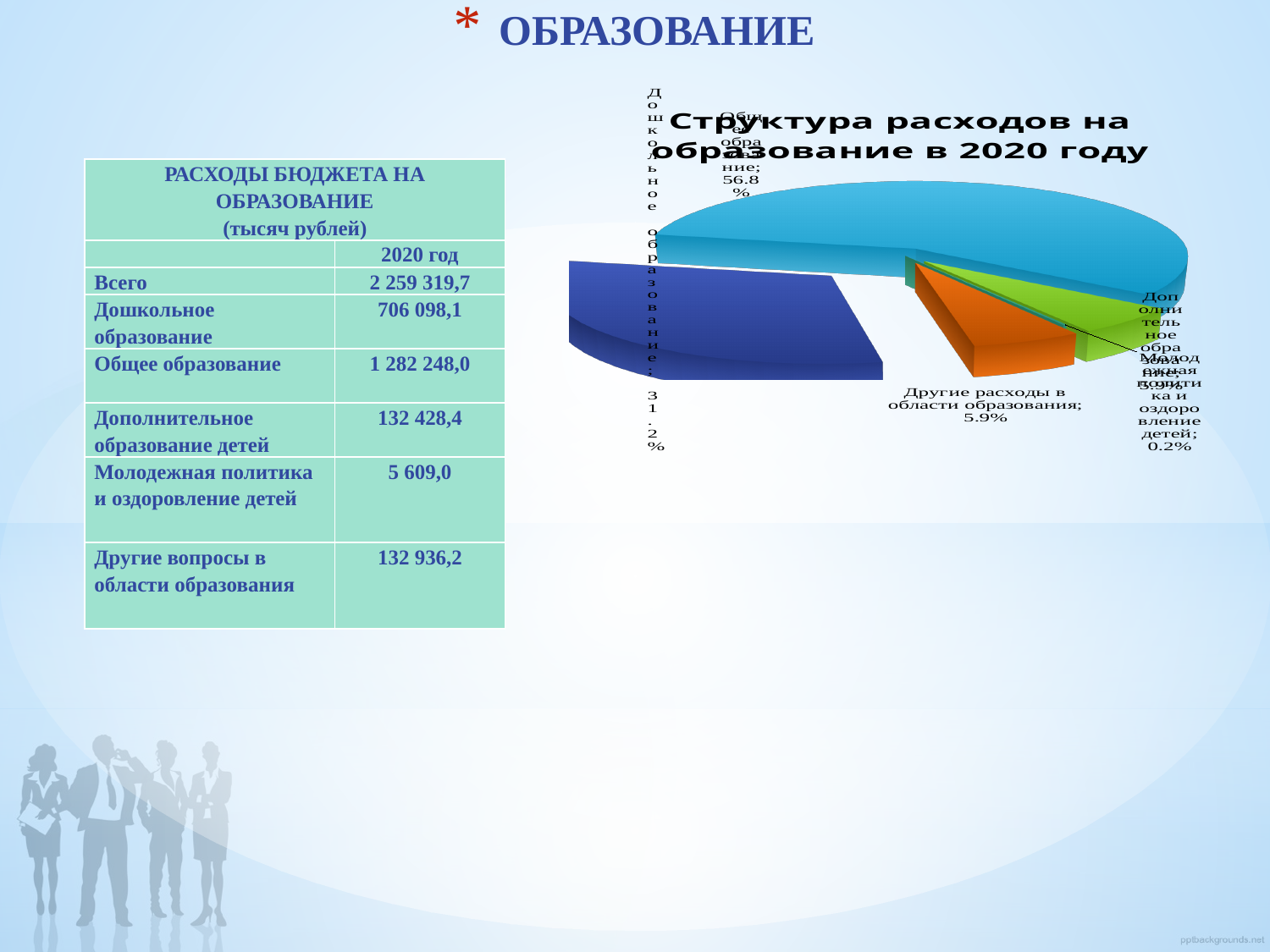
Which category has the smallest slice in the pie chart? Молодежная политика и оздоровление детей In the pie chart, which is larger: the share for Общее образование or the share for Дошкольное образование? Общее образование In the pie chart, what is the difference between the share for Общее образование and the share for Дошкольное образование? 25.6% In the pie chart, what share is shown for Другие расходы в области образования? 5.9% What is the title of the pie chart? Структура расходов на образование в 2020 году In the pie chart, what share is shown for Молодежная политика и оздоровление детей? 0.2% In the pie chart, which is larger: the share for Другие расходы в области образования or the share for Молодежная политика и оздоровление детей? Другие расходы в области образования In the pie chart, what share is shown for Дошкольное образование? 31.2% What kind of chart is shown on the slide? pie chart Which category has the largest slice in the pie chart? Общее образование How many slices does the pie chart have? 5 In the pie chart, what share is shown for Общее образование? 56.8%